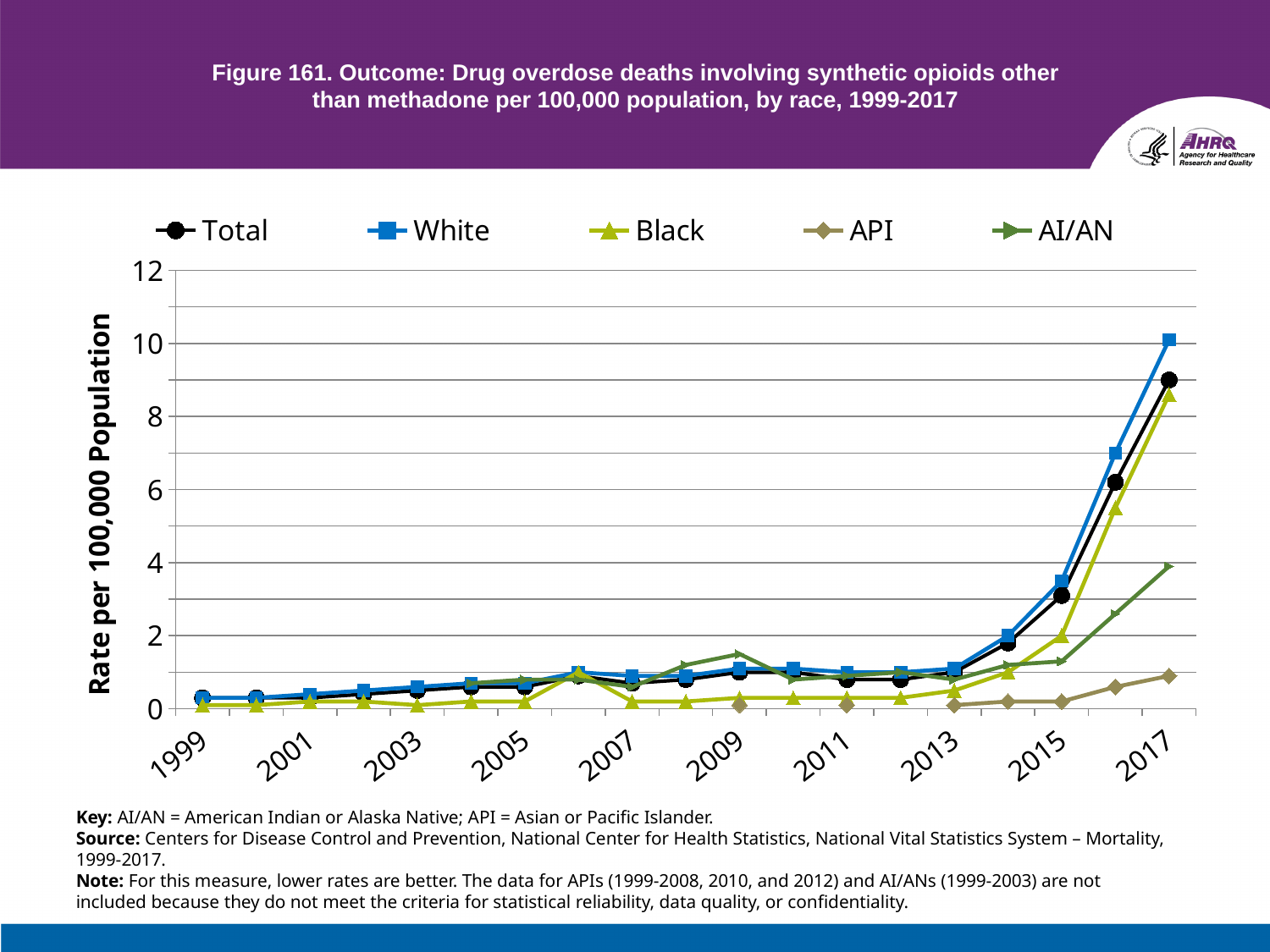
How many series does the legend list? 5 Is the value for Total in 2013 greater or less than 2? less Does the White series rise or fall from 2013 to 2017? rise Which series has the lowest value in 2017? API What is the label on the y axis? Rate per 100,000 Population What kind of chart is shown on the slide? line chart Which series has the highest value in 2017? White What is the first year and the last year shown on the x axis? 1999 and 2017 In 2017, which is larger, the value for Black or the value for AI/AN? Black Is the value for AI/AN in 2017 greater or less than 6? less Is the value for White in 2017 greater or less than 8? greater